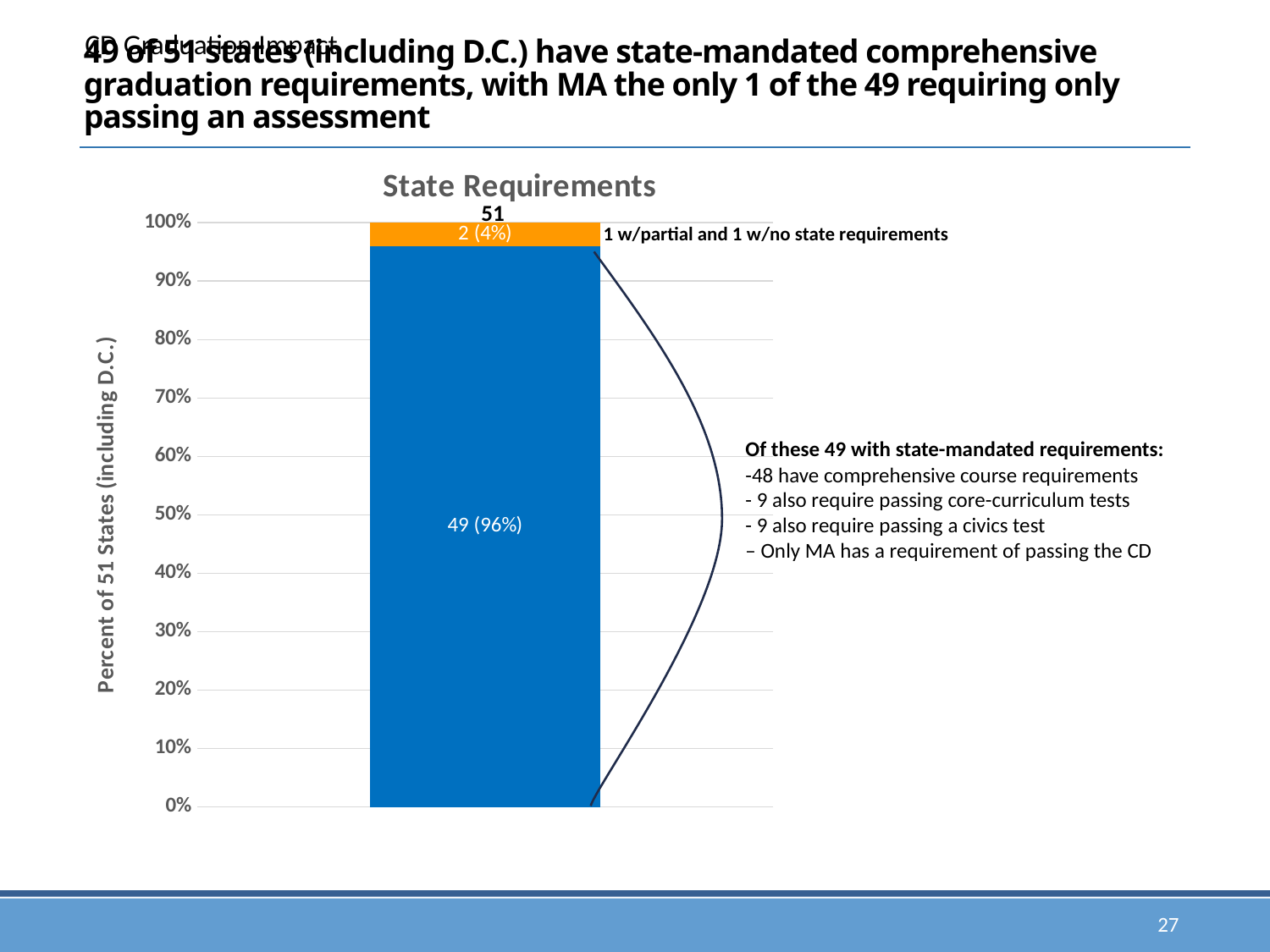
What is the difference in the number of states between the blue segment and the orange segment? 47 What kind of chart is shown on the slide? stacked bar chart Is the value for the blue segment greater or less than 90%? greater How many segments make up the stacked bar? 2 What percentage of the 51 states does the blue segment represent? 96% What is the data label on the blue segment of the bar? 49 (96%) What percentage of the 51 states does the orange segment represent? 4% What is the title of the chart? State Requirements What is the data label on the orange segment of the bar? 2 (4%) Which segment of the bar is larger, the blue one or the orange one? the blue one What total is printed above the stacked bar? 51 What is the label on the vertical axis of the chart? Percent of 51 States (including D.C.)